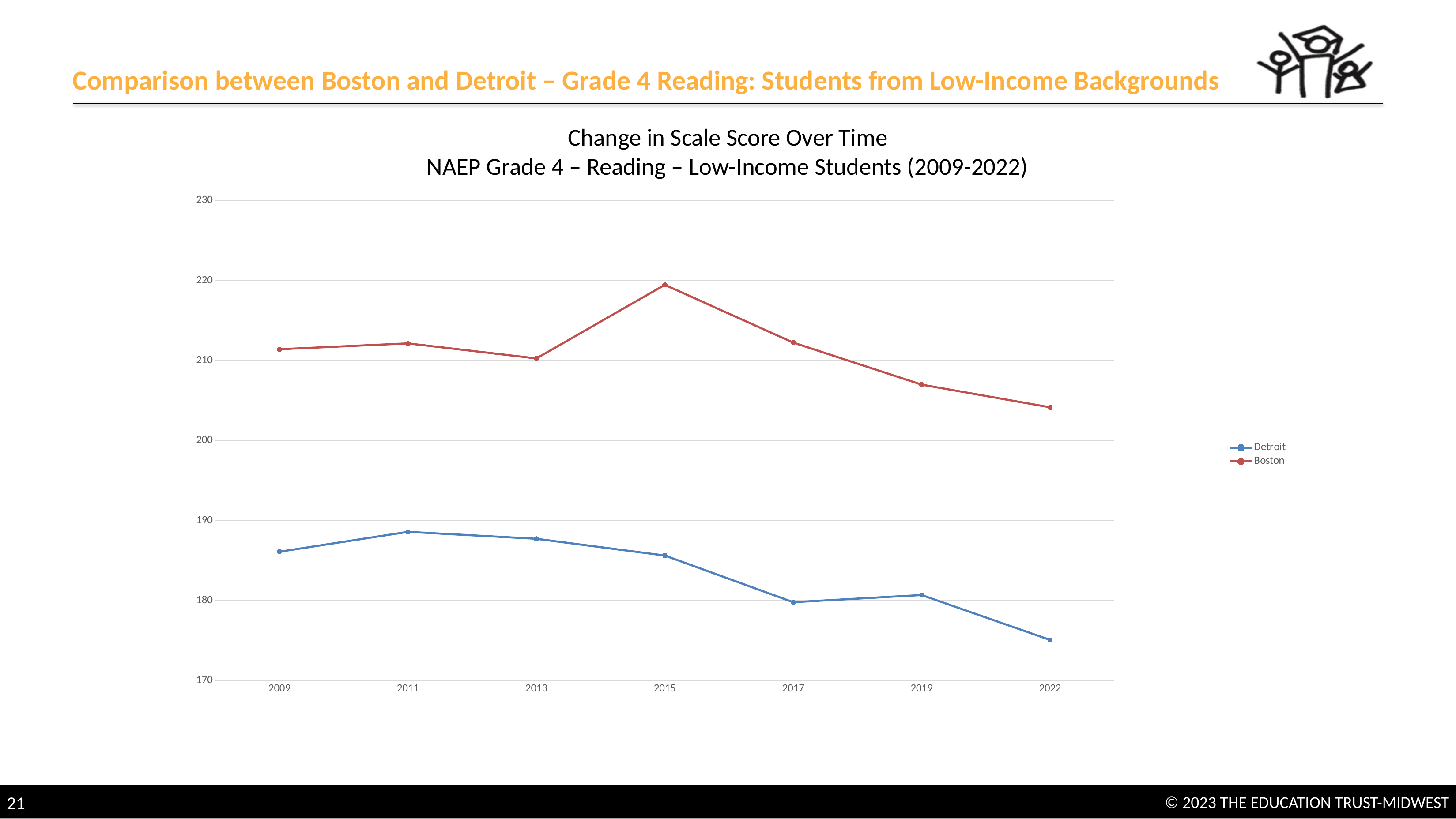
Is the value for Detroit in 2022 greater or less than 180? less In which year does the Detroit line reach its lowest value? 2022 In which year does the Boston line reach its lowest value? 2022 How many years are plotted along the x axis? 7 Does the Detroit line rise or fall overall from 2009 to 2022? fall How many series does the legend list? 2 Is the value for Boston in 2022 greater or less than 210? less Is the value for Boston in 2015 greater or less than 210? greater In which year does the Boston line reach its highest value? 2015 What kind of chart is shown on the slide? line chart Which series has the higher value in 2019, Detroit or Boston? Boston Which two series are listed in the legend? Detroit and Boston